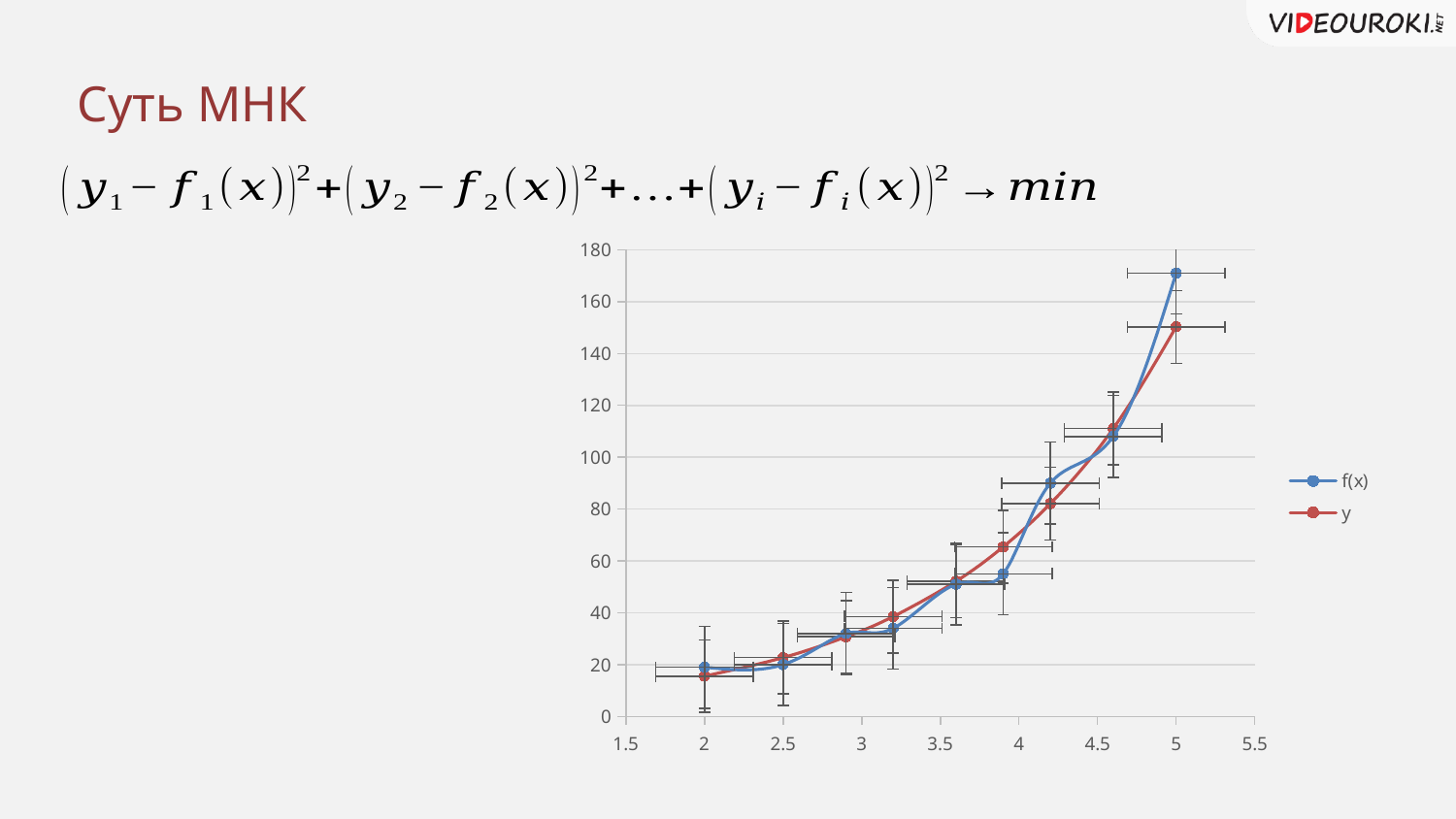
How many data points does the y series have? 9 Is the value of y at x = 5 greater or less than 160? less At x = 5, which series has the larger value, f(x) or y? f(x) Is the value of y at x = 4.6 greater or less than 100? greater What kind of chart is shown on the slide? line chart Do the values of the f(x) series rise or fall as x increases? rise Is the value of y at x = 4.2 greater or less than 60? greater How many series does the chart legend list? 2 At which x value does the f(x) series reach its highest value? 5 What are the names of the two series in the legend? f(x) and y